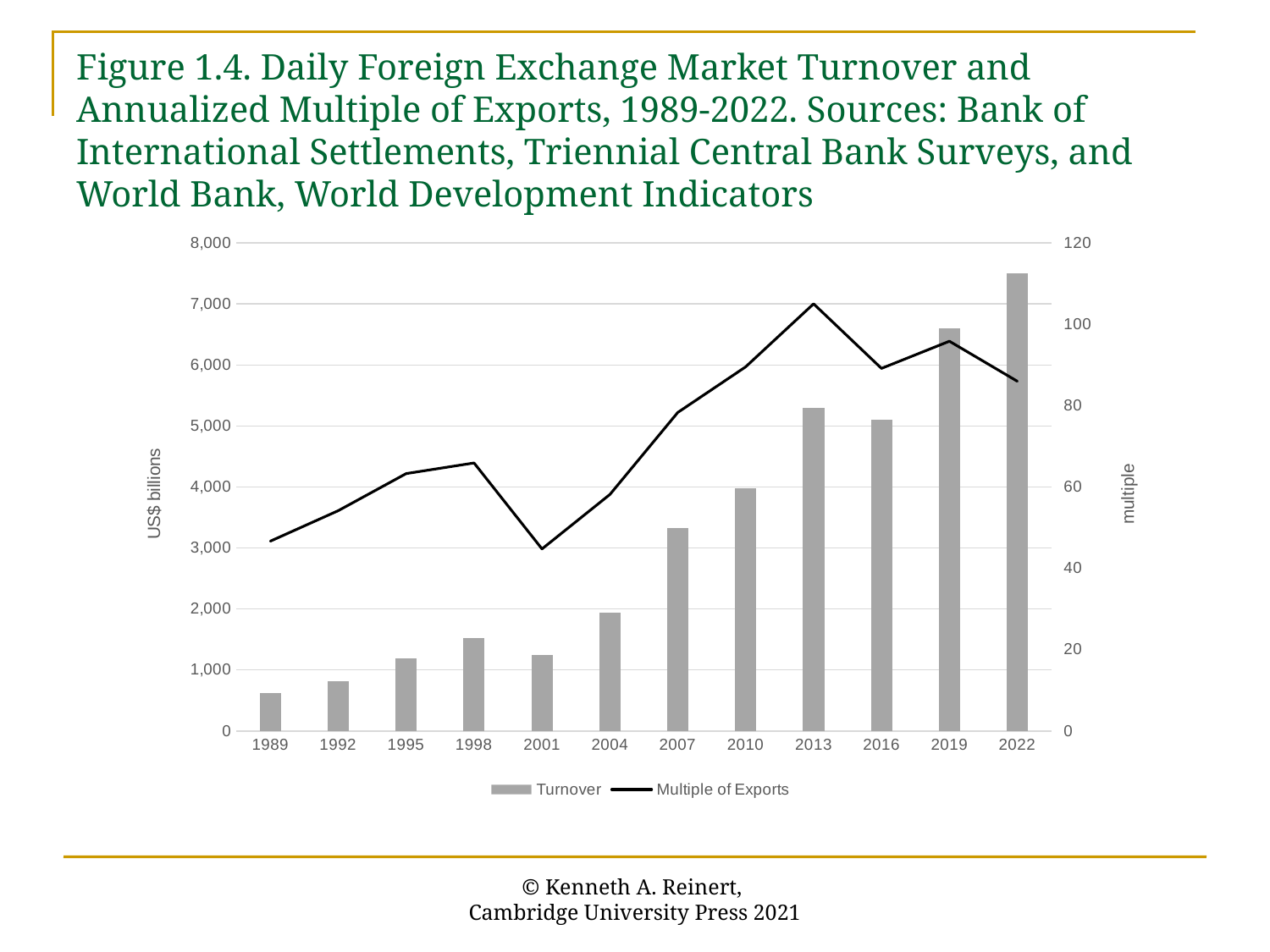
Is the Turnover value for 2022 greater or less than 7,000? greater Is the Turnover value for 1989 greater or less than 1,000? less What kind of chart is shown on the slide? bar chart combined with a line In which year is Turnover highest? 2022 In which year is Turnover lowest? 1989 In which year does the Multiple of Exports line reach its highest point? 2013 Which year has the larger Turnover, 2016 or 2019? 2019 Does Turnover generally rise or fall from 1989 to 2022? rise How many series does the chart's legend list? 2 Is the Multiple of Exports value for 2013 greater or less than 100? greater What is the label on the left vertical axis of the chart? US$ billions How many years are shown on the x axis of the chart? 12